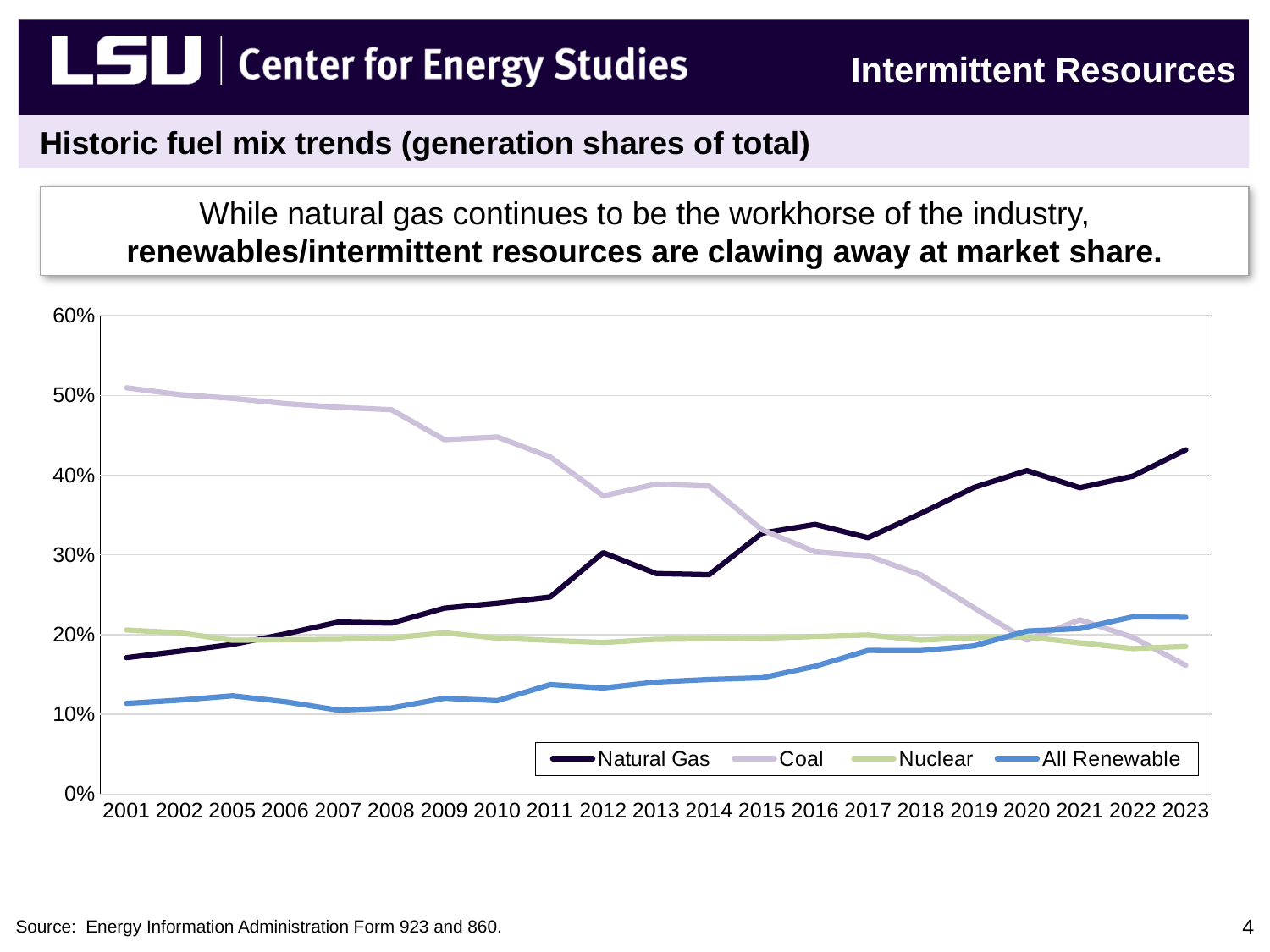
Is the value for Coal in 2023 greater or less than 20%? less Is the value for Natural Gas in 2023 greater or less than 40%? greater Which series has the lowest generation share in 2023? Coal How many years are shown along the x axis? 21 Which is larger in 2001, the Natural Gas share or the Coal share? Coal How many series does the legend list? 4 What is the title of the chart section on the slide? Historic fuel mix trends (generation shares of total) What kind of chart is shown on the slide? Line chart Which series has the highest generation share in 2001? Coal Does the Coal share rise or fall from 2001 to 2023? Fall Does the Natural Gas share rise or fall from 2001 to 2023? Rise Which series has the highest generation share in 2023? Natural Gas